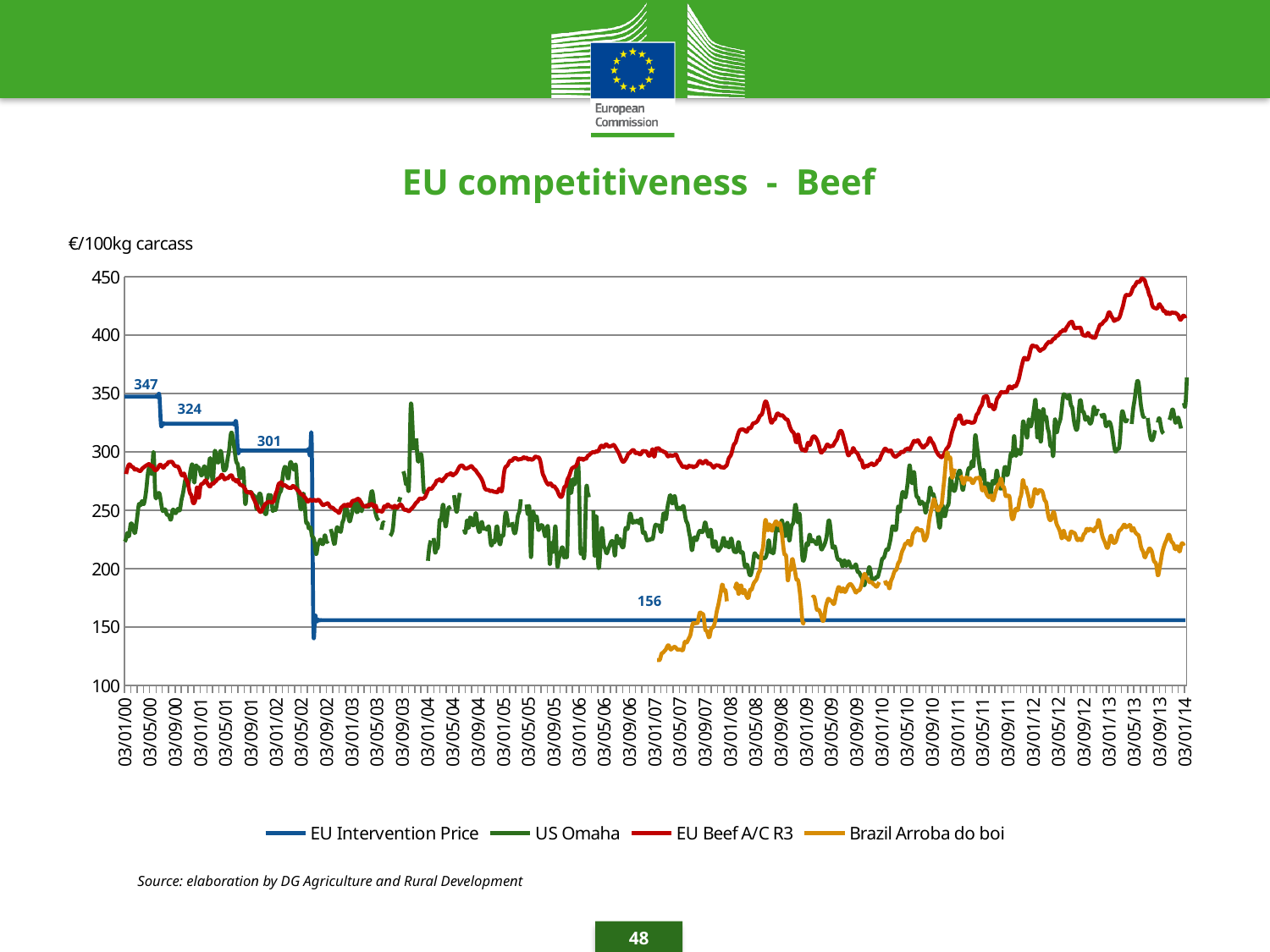
What labelled value does the EU Intervention Price take between 324 and 156? 301 What is the first labelled value of the EU Intervention Price series? 347 What is the difference between the EU Intervention Price labels 347 and 324? 23 Is the value for EU Beef A/C R3 at 03/01/14 greater or less than 400? greater What unit is shown above the y axis of the chart? €/100kg carcass What is the final labelled value of the EU Intervention Price series? 156 What kind of chart is shown on the slide? line chart Is the value for Brazil Arroba do boi at 03/01/07 greater or less than 150? less Which series has the highest value at the right end of the chart (03/01/14)? EU Beef A/C R3 Does the EU Intervention Price rise or fall over the period shown? fall How many series does the legend list? 4 By how much does the EU Intervention Price fall from its 301 level to its 156 level? 145